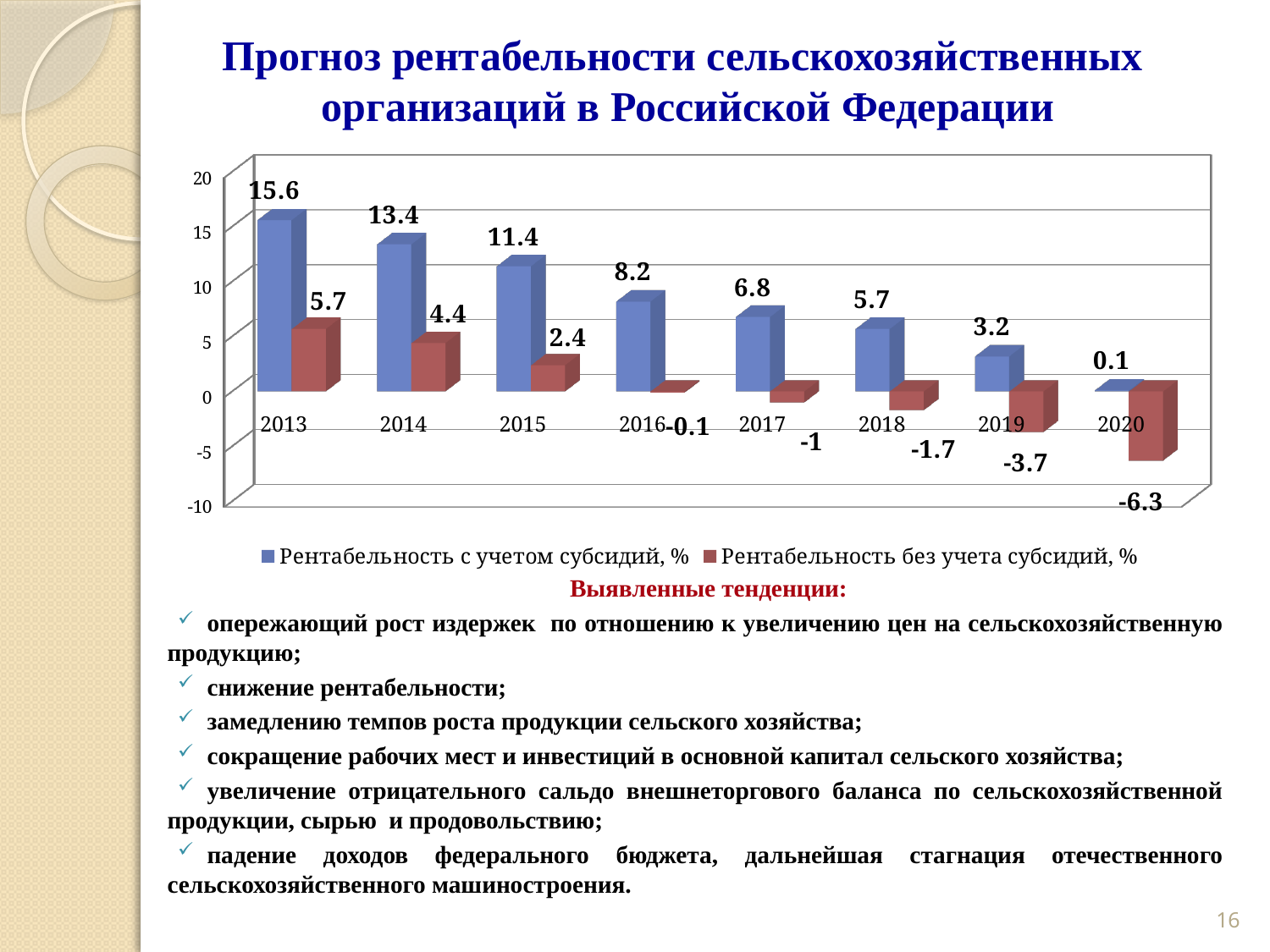
How many years are shown on the x axis of the chart? 8 Which year has the lowest value of "Рентабельность без учета субсидий, %"? 2020 What is the value of "Рентабельность с учетом субсидий, %" for 2013? 15.6 What is the difference between "Рентабельность с учетом субсидий, %" and "Рентабельность без учета субсидий, %" in 2014? 9 What is the value of "Рентабельность без учета субсидий, %" for 2016? -0.1 What kind of chart is shown on the slide? Bar chart Which year has the highest value of "Рентабельность с учетом субсидий, %"? 2013 What is the value of "Рентабельность с учетом субсидий, %" for 2019? 3.2 What is the value of "Рентабельность без учета субсидий, %" for 2020? -6.3 How many series does the chart legend list? 2 Do the values of "Рентабельность с учетом субсидий, %" rise or fall from 2013 to 2020? Fall Which is larger: "Рентабельность с учетом субсидий, %" in 2015 or in 2017? 2015